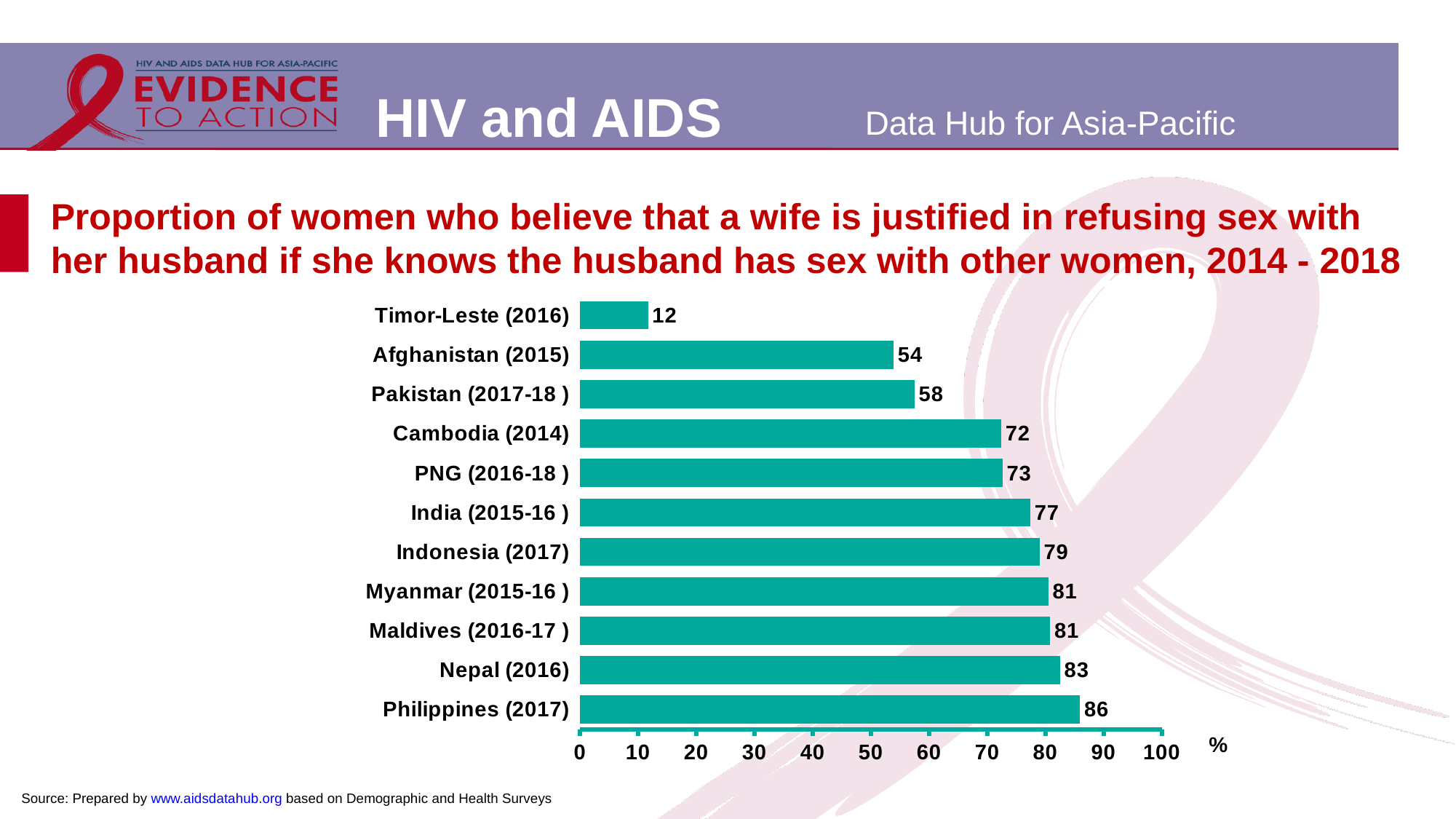
What is the difference between the values for Philippines (2017) and Timor-Leste (2016)? 74 Which country has the lowest proportion? Timor-Leste (2016) Which is larger, the value for Nepal (2016) or the value for Indonesia (2017)? Nepal (2016) Which country has the highest proportion? Philippines (2017) What unit is shown at the end of the x axis? % What is the value for Philippines (2017)? 86 Is the value for India (2015-16) greater or less than 70? greater What is the value for Cambodia (2014)? 72 What is the value for Afghanistan (2015)? 54 What kind of chart is shown on the slide? bar chart What is the difference between the values for Pakistan (2017-18) and Afghanistan (2015)? 4 How many countries are shown in the chart? 11